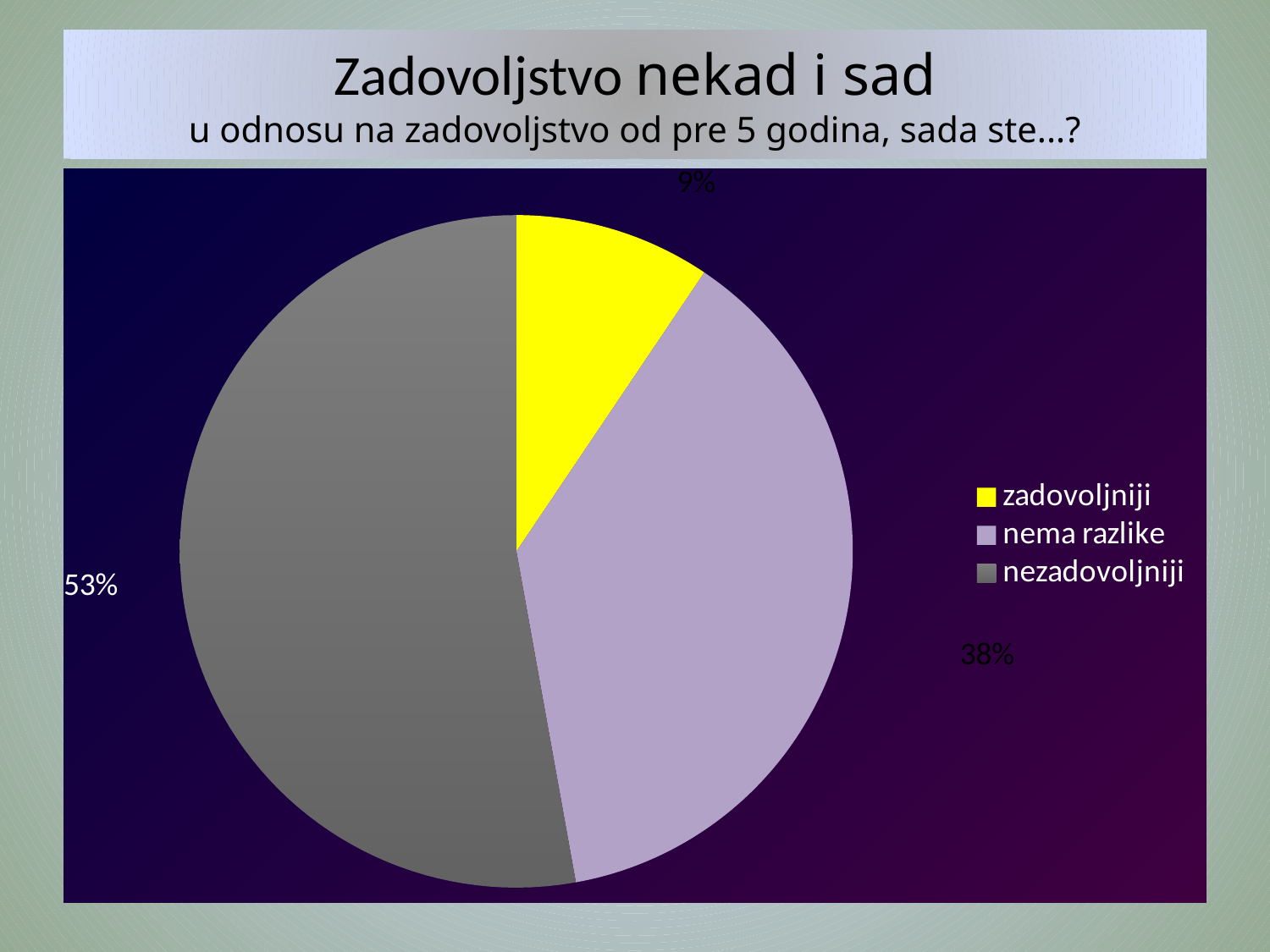
What share of the pie does "nema razlike" have? 38% What share of the pie does "zadovoljniji" have? 9% What is the main title of the chart slide? Zadovoljstvo nekad i sad What is the difference in percentage points between "nezadovoljniji" and "nema razlike"? 15 Which is larger, the slice for "nema razlike" or the slice for "zadovoljniji"? nema razlike What kind of chart is shown on the slide? pie chart What colour is the slice for "zadovoljniji"? yellow What is the difference in percentage points between "nema razlike" and "zadovoljniji"? 29 How many categories does the pie chart have? 3 What share of the pie does "nezadovoljniji" have? 53% Which category has the largest slice of the pie? nezadovoljniji Which category has the smallest slice of the pie? zadovoljniji